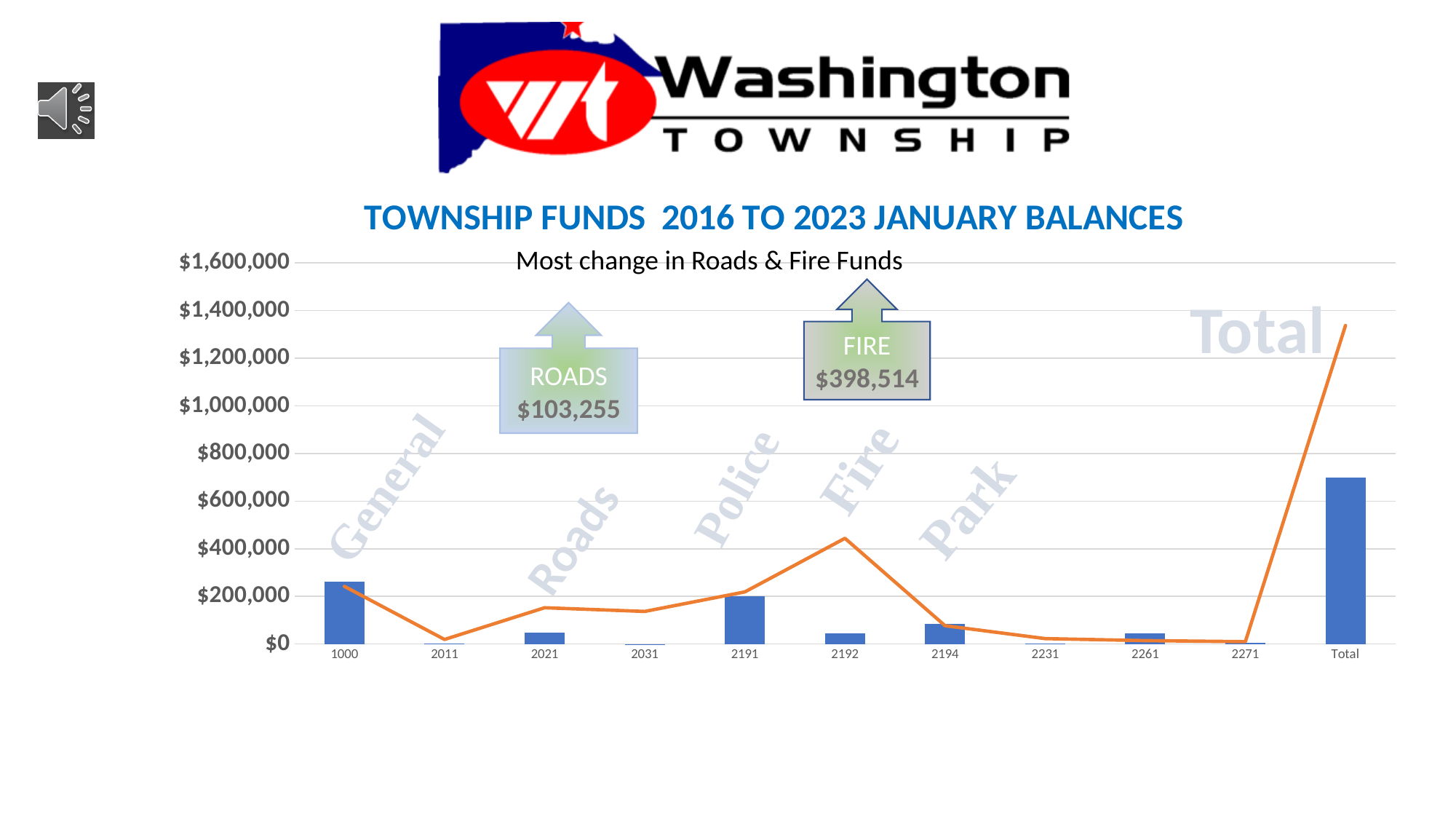
Is the orange line value for Total greater or less than $1,200,000? greater Excluding the Total category, which fund code has the tallest blue bar? 1000 Which has the higher orange line value, fund 2191 or fund 2192? 2192 Which has the taller blue bar, fund 1000 or fund 2191? 1000 Is the blue bar for fund 2192 greater or less than $200,000? less Does the orange line rise or fall from fund 2192 to fund 2271? Fall What is the title of the chart? TOWNSHIP FUNDS 2016 TO 2023 JANUARY BALANCES How many categories are shown along the x axis of the chart? 11 Is the blue bar for fund 1000 greater or less than $200,000? greater What kind of chart is shown on the slide? A bar chart combined with a line chart Which category has the tallest blue bar? Total